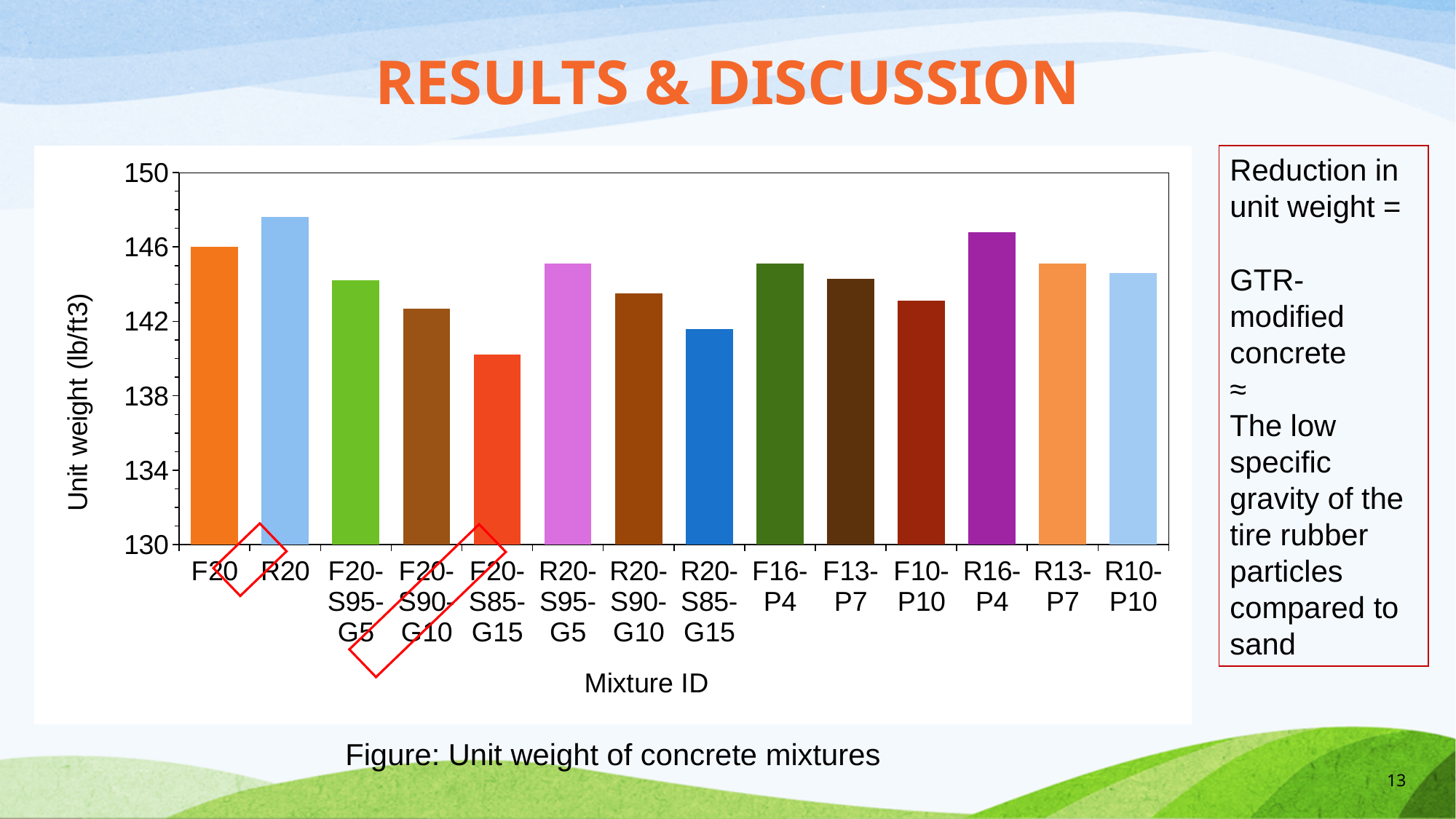
Which mixture has the highest unit weight in the chart? R20 Which has the larger unit weight, F20 or F20-S85-G15? F20 Which has the larger unit weight, F20-S95-G5 or F20-S90-G10? F20-S95-G5 Is the unit weight for F20-S85-G15 greater or less than 142? less Is the unit weight for F16-P4 greater or less than 142? greater Which mixture has the lowest unit weight in the chart? F20-S85-G15 What is the label of the y axis of the chart? Unit weight (lb/ft3) Is the unit weight for R20 greater or less than 146? greater Do the unit weights rise or fall going from F20-S95-G5 to F20-S90-G10 to F20-S85-G15? fall How many mixture IDs are plotted on the x axis of the chart? 14 What kind of chart is shown on the slide? bar chart